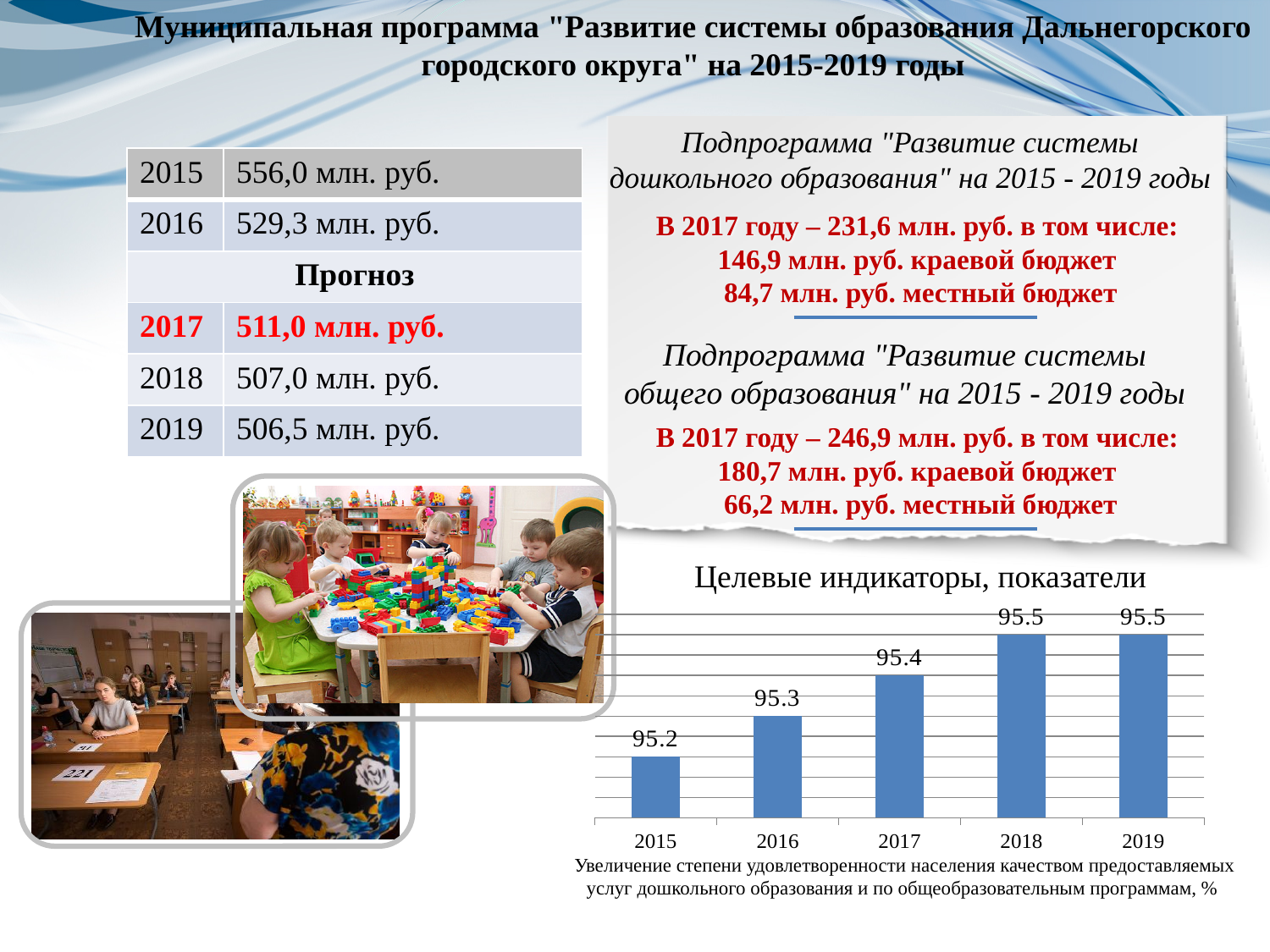
Which is larger in the chart, the value for 2016 or the value for 2018? 2018 What is the title of the chart on the slide? Целевые индикаторы, показатели What is the difference between the values for 2018 and 2015 in the chart? 0.3 What is the value for 2015 in the chart? 95.2 Do the values in the chart rise or fall from 2015 to 2019? rise What is the value for 2017 in the chart? 95.4 What kind of chart is shown on the slide? bar chart What is the value for 2016 in the chart? 95.3 What is the difference between the values for 2017 and 2016 in the chart? 0.1 How many years are shown on the x axis of the chart? 5 What is the value for 2019 in the chart? 95.5 Which year has the lowest value in the chart? 2015